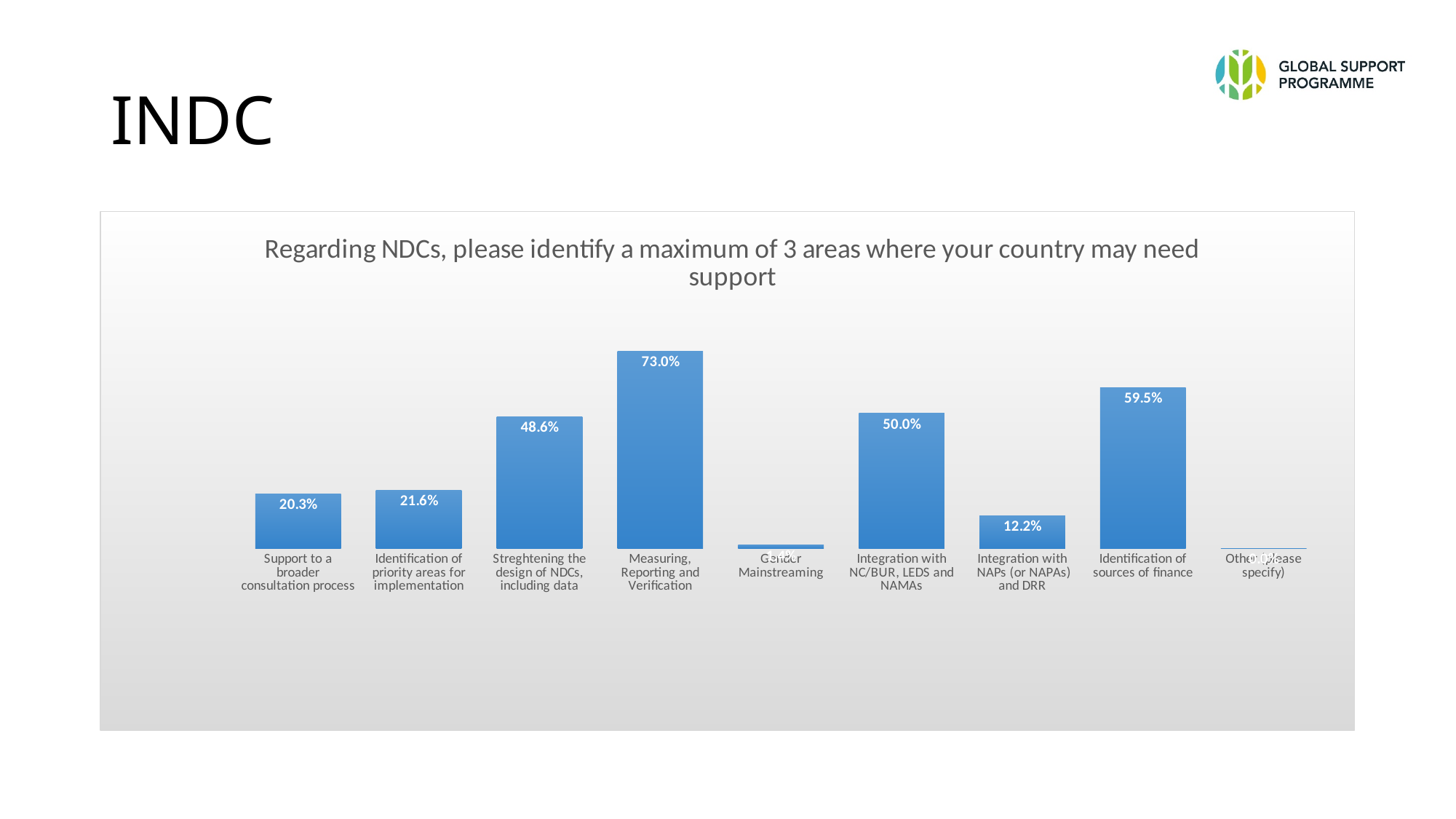
What is the difference between Measuring, Reporting and Verification and Identification of sources of finance? 13.5% How many categories are shown on the x axis? 9 What is the value for Integration with NAPs (or NAPAs) and DRR? 12.2% Which area has the highest value? Measuring, Reporting and Verification What kind of chart is shown? Bar chart What is the difference between Integration with NC/BUR, LEDS and NAMAs and Integration with NAPs (or NAPAs) and DRR? 37.8% What is the value for Measuring, Reporting and Verification? 73.0% Which is larger: Identification of priority areas for implementation or Streghtening the design of NDCs, including data? Streghtening the design of NDCs, including data What is the value for Streghtening the design of NDCs, including data? 48.6% What is the value for Support to a broader consultation process? 20.3% What is the title of the chart? Regarding NDCs, please identify a maximum of 3 areas where your country may need support What is the value for Identification of sources of finance? 59.5%